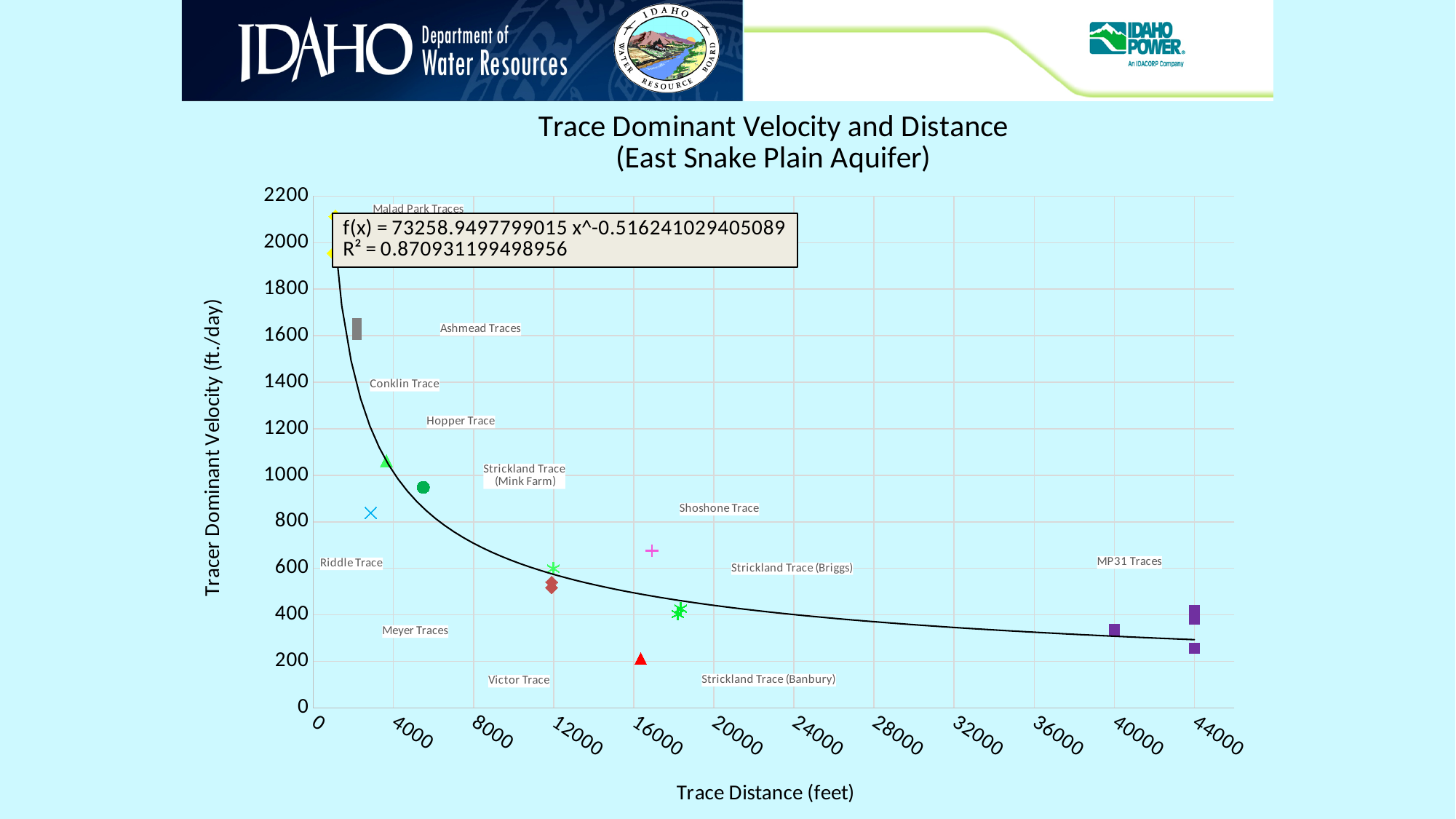
Which has the higher tracer dominant velocity, the Shoshone Trace or the Victor Trace? Shoshone Trace Is the velocity for the Victor Trace greater or less than 400 ft./day? less Is the velocity for the Shoshone Trace greater or less than 600 ft./day? greater What is the title of the chart? Trace Dominant Velocity and Distance (East Snake Plain Aquifer) What kind of chart is shown on the slide? Scatter chart Is the velocity for the Riddle Trace greater or less than 1000 ft./day? less Which trace group has the highest tracer dominant velocity? Malad Park Traces What R² value is printed on the chart for the fitted curve? 0.870931199498956 Which trace group is plotted at the greatest trace distance? MP31 Traces What is the label of the y axis? Tracer Dominant Velocity (ft./day) As trace distance increases along the x axis, does the fitted tracer dominant velocity rise or fall? Fall